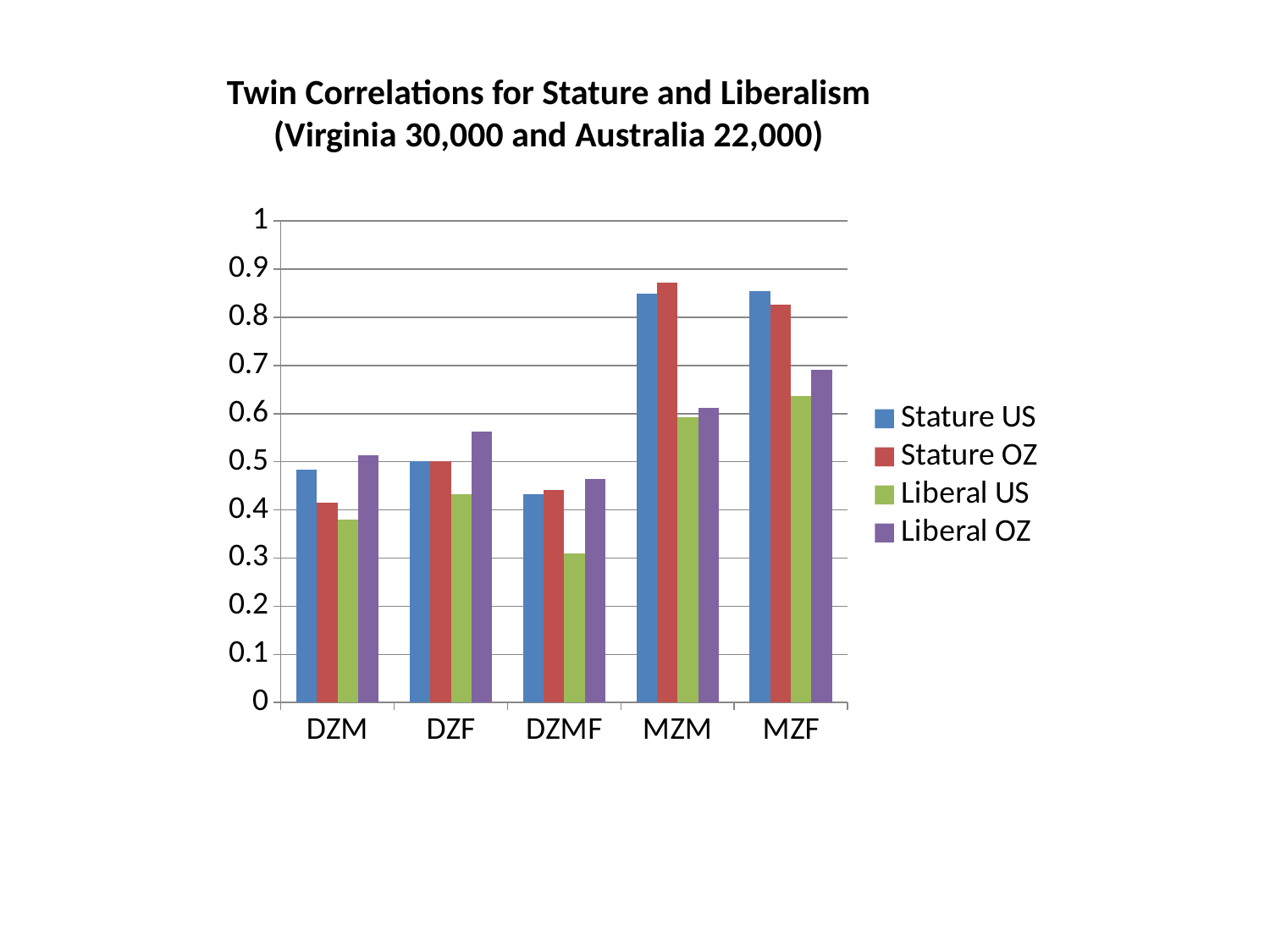
Which category has the lowest value for Liberal OZ? DZMF What is the title of the chart? Twin Correlations for Stature and Liberalism (Virginia 30,000 and Australia 22,000) How many categories are shown on the x axis? 5 In the MZM category, which is larger: Stature OZ or Liberal OZ? Stature OZ Is the value for Liberal OZ in the DZF category greater or less than 0.5? greater Is the value for Liberal OZ in the MZF category greater or less than 0.6? greater How many series does the legend list? 4 Which category has the lowest value for Liberal US? DZMF Is the value for Liberal US in the DZMF category greater or less than 0.4? less What kind of chart is shown on the slide? bar chart Which category has the highest value for Liberal US? MZF